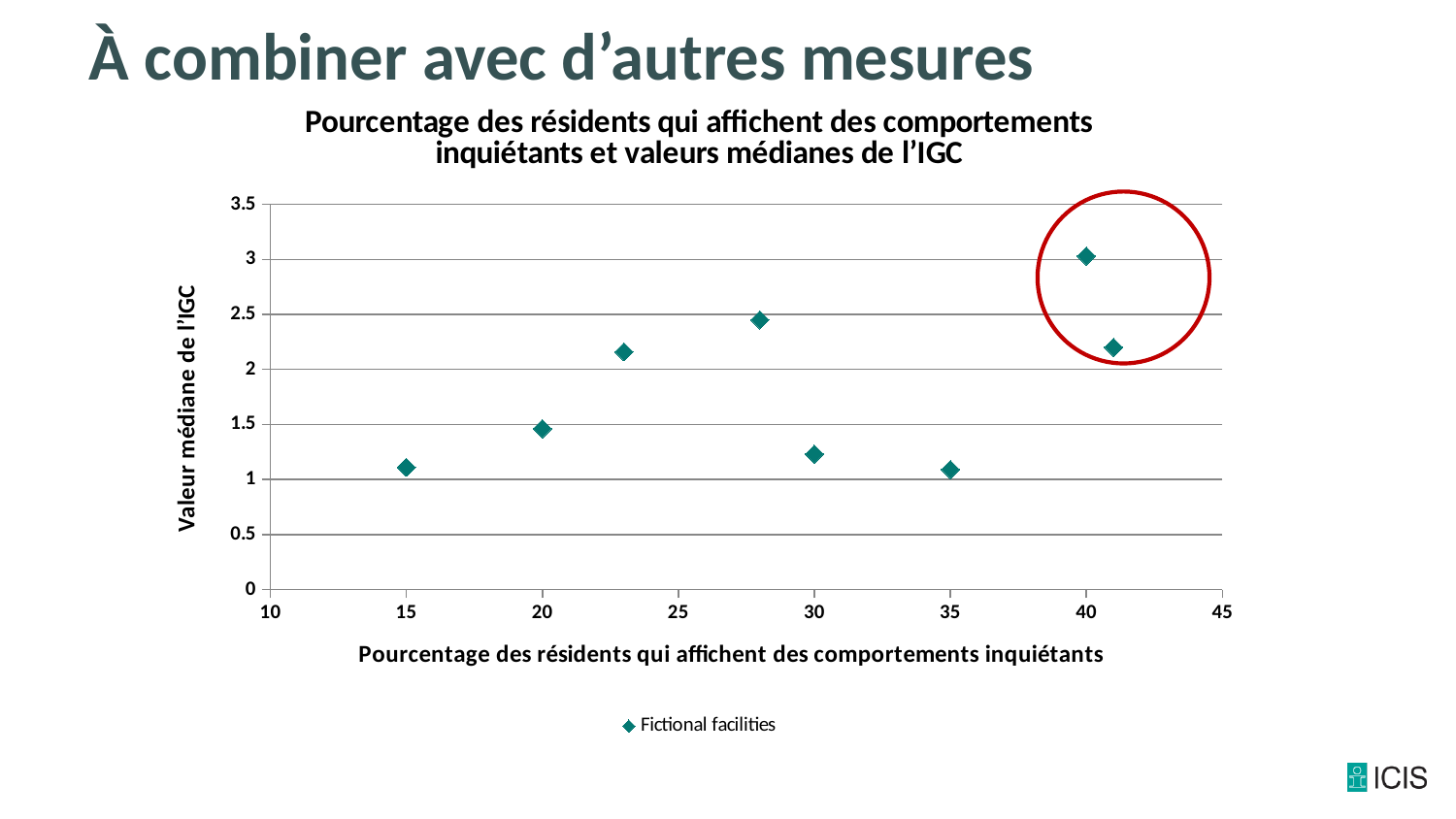
How many data points are enclosed by the red circle? 2 Which point has a higher median IGC value: the one at 28% or the one at 30%? 28% How many series does the legend list? 1 What is the name of the series shown in the legend? Fictional facilities Is the median IGC value for the point at 20% greater or less than 2? less Is the median IGC value for the point at 35% greater or less than 1.5? less Is the median IGC value for the point at 28% greater or less than 2? greater How many data points are plotted on the chart? 8 At which percentage of residents (x value) is the median IGC value highest? 40 What kind of chart is shown on the slide? Scatter chart What is the label of the vertical axis? Valeur médiane de l'IGC